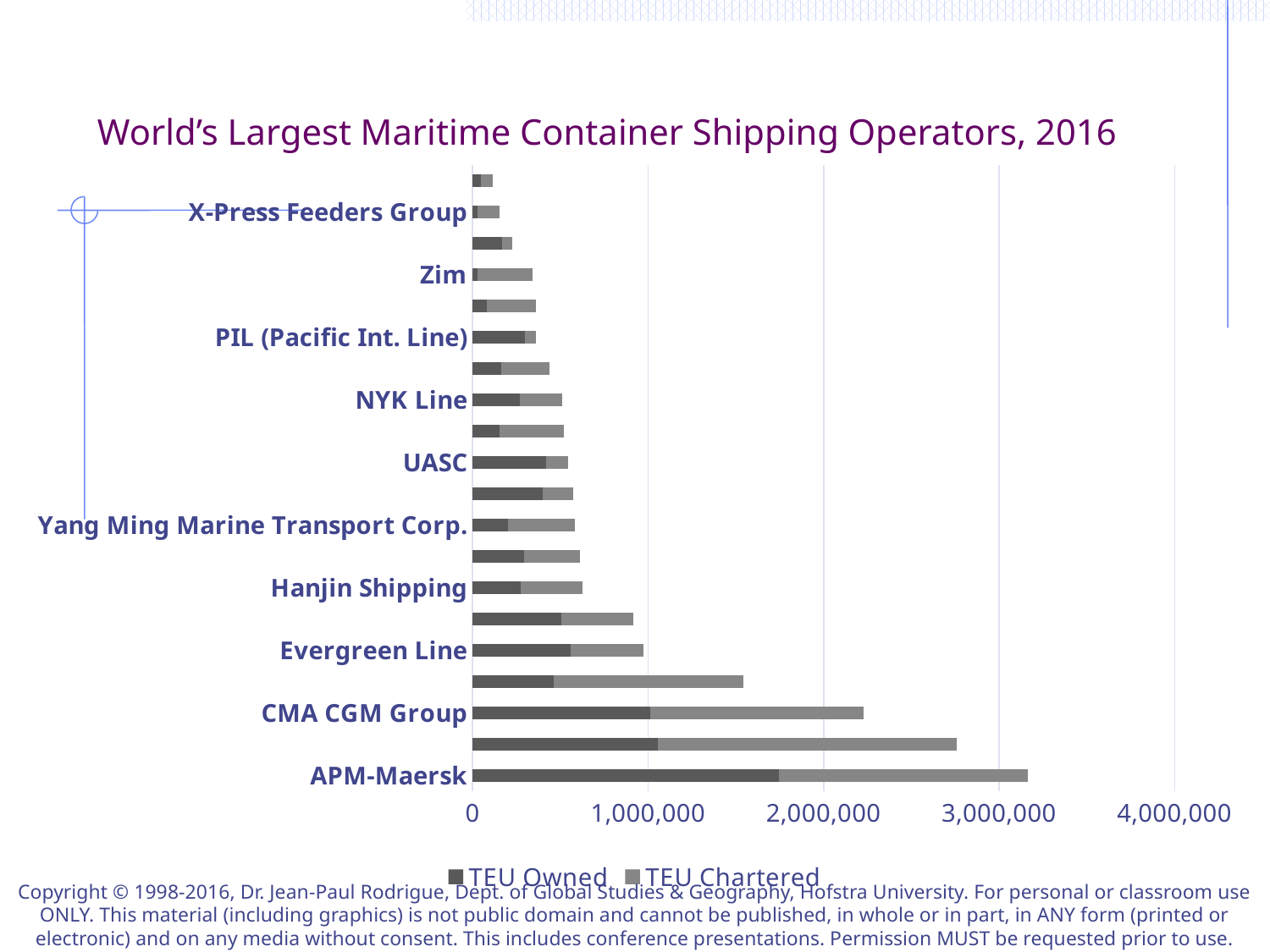
Which labeled operator has the shortest total bar? X-Press Feeders Group Is the total bar for Evergreen Line greater or less than 1,000,000? less Which labeled operator has the longest total bar? APM-Maersk Is the total bar for APM-Maersk greater or less than 3,000,000? greater Is the total bar for CMA CGM Group greater or less than 2,000,000? greater Do the total bars get longer or shorter moving from the top of the chart to the bottom? longer How many series does the legend list? 2 What kind of chart is shown on the slide? Stacked bar chart What is the title of the chart? World's Largest Maritime Container Shipping Operators, 2016 Which has the longer total bar, Evergreen Line or Hanjin Shipping? Evergreen Line What are the two series named in the legend? TEU Owned and TEU Chartered